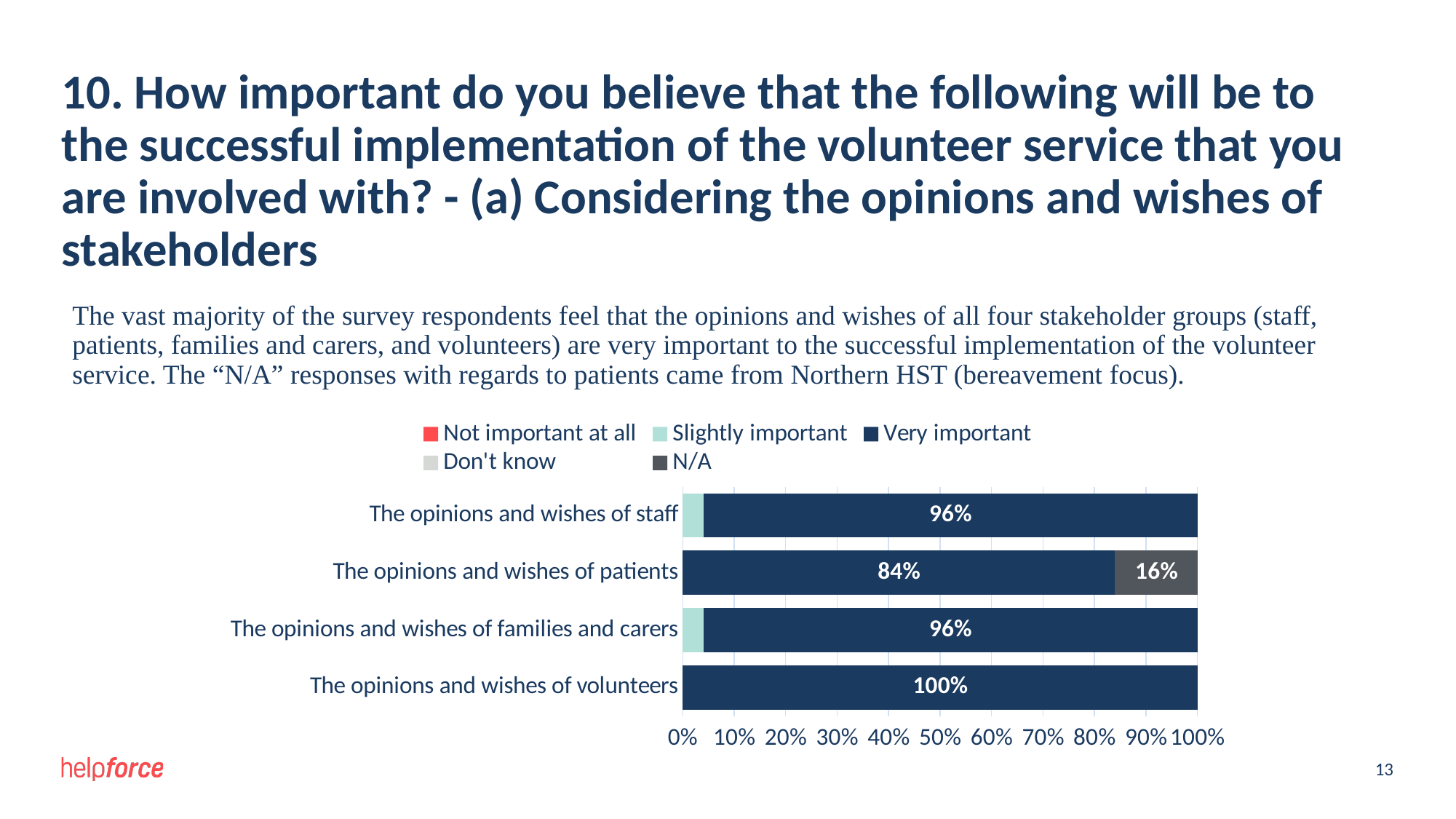
Which has a larger Very important value: the opinions and wishes of staff or the opinions and wishes of patients? The opinions and wishes of staff What is the Very important value for the opinions and wishes of patients? 84% What is the Very important value for the opinions and wishes of volunteers? 100% How many series does the legend list? 5 Which category has the lowest Very important value? The opinions and wishes of patients Is the Slightly important value for the opinions and wishes of staff greater or less than 10%? less What is the difference between the Very important values for volunteers and patients? 16% What percentage of respondents rated the opinions and wishes of staff as Very important? 96% What is the N/A value for the opinions and wishes of patients? 16% Which category has the highest Very important value? The opinions and wishes of volunteers How many categories are shown in the chart? 4 What kind of chart is shown on the slide? Stacked bar chart